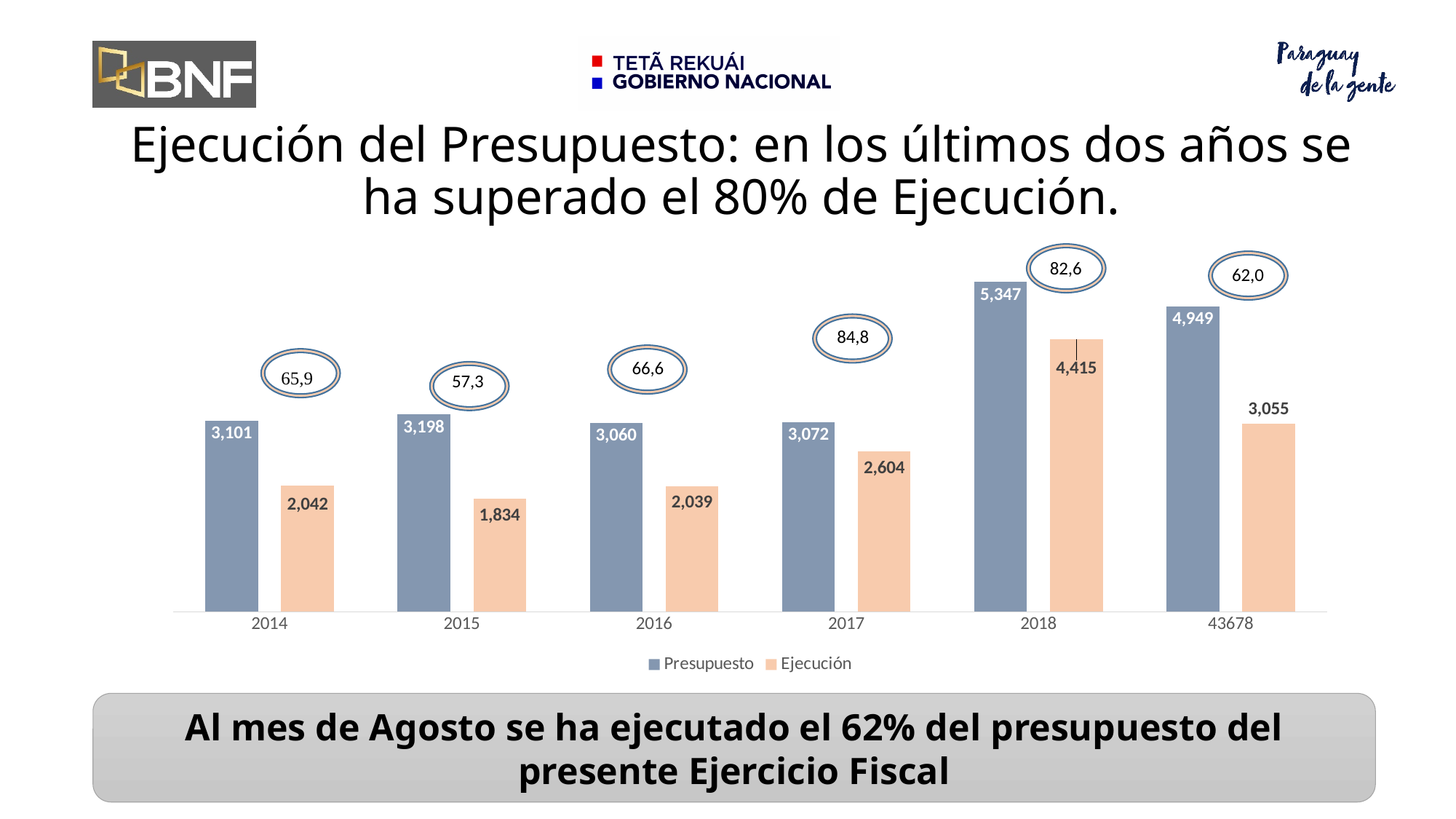
What is the Ejecución value for 2017? 2,604 What is the difference between the Ejecución values for 2017 and 2016? 565 Which year has the lowest Ejecución value? 2015 How many series does the legend list? 2 What is the Presupuesto value for the category labelled 43678? 4,949 What is the Presupuesto value for 2018? 5,347 What is the difference between Presupuesto and Ejecución in 2018? 932 What is the Ejecución value for 2015? 1,834 How many categories are shown on the x axis? 6 What kind of chart is shown on the slide? Bar chart Which is larger, the Ejecución value for 2014 or for 2016? 2014 Which year has the highest Presupuesto value? 2018